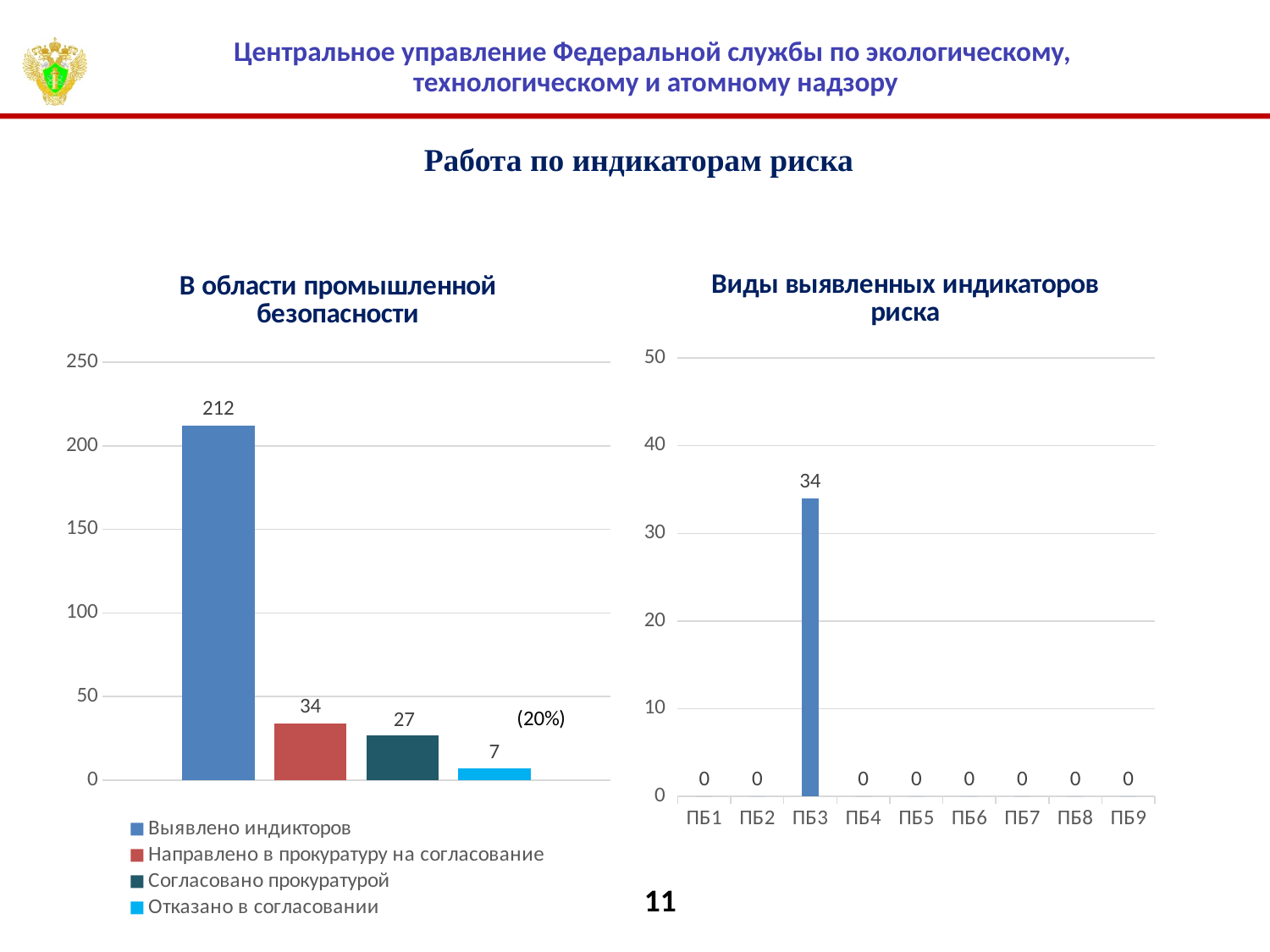
In the chart 'В области промышленной безопасности', how many series does the legend list? 4 In the chart 'Виды выявленных индикаторов риска', what is the value for ПБ3? 34 What kind of chart is 'Виды выявленных индикаторов риска'? bar chart In the chart 'В области промышленной безопасности', what is the value for 'Согласовано прокуратурой'? 27 In the chart 'В области промышленной безопасности', what is the difference between 'Направлено в прокуратуру на согласование' and 'Согласовано прокуратурой'? 7 In the chart 'В области промышленной безопасности', which series has the lowest value? Отказано в согласовании In the chart 'В области промышленной безопасности', what is the value for 'Выявлено индикторов'? 212 In the chart 'Виды выявленных индикаторов риска', which category has the highest value? ПБ3 In the chart 'Виды выявленных индикаторов риска', how many categories are shown on the x axis? 9 In the chart 'В области промышленной безопасности', what is the value for 'Отказано в согласовании'? 7 In the chart 'Виды выявленных индикаторов риска', what is the value for ПБ5? 0 In the chart 'В области промышленной безопасности', is the value for 'Выявлено индикторов' greater or less than 200? greater